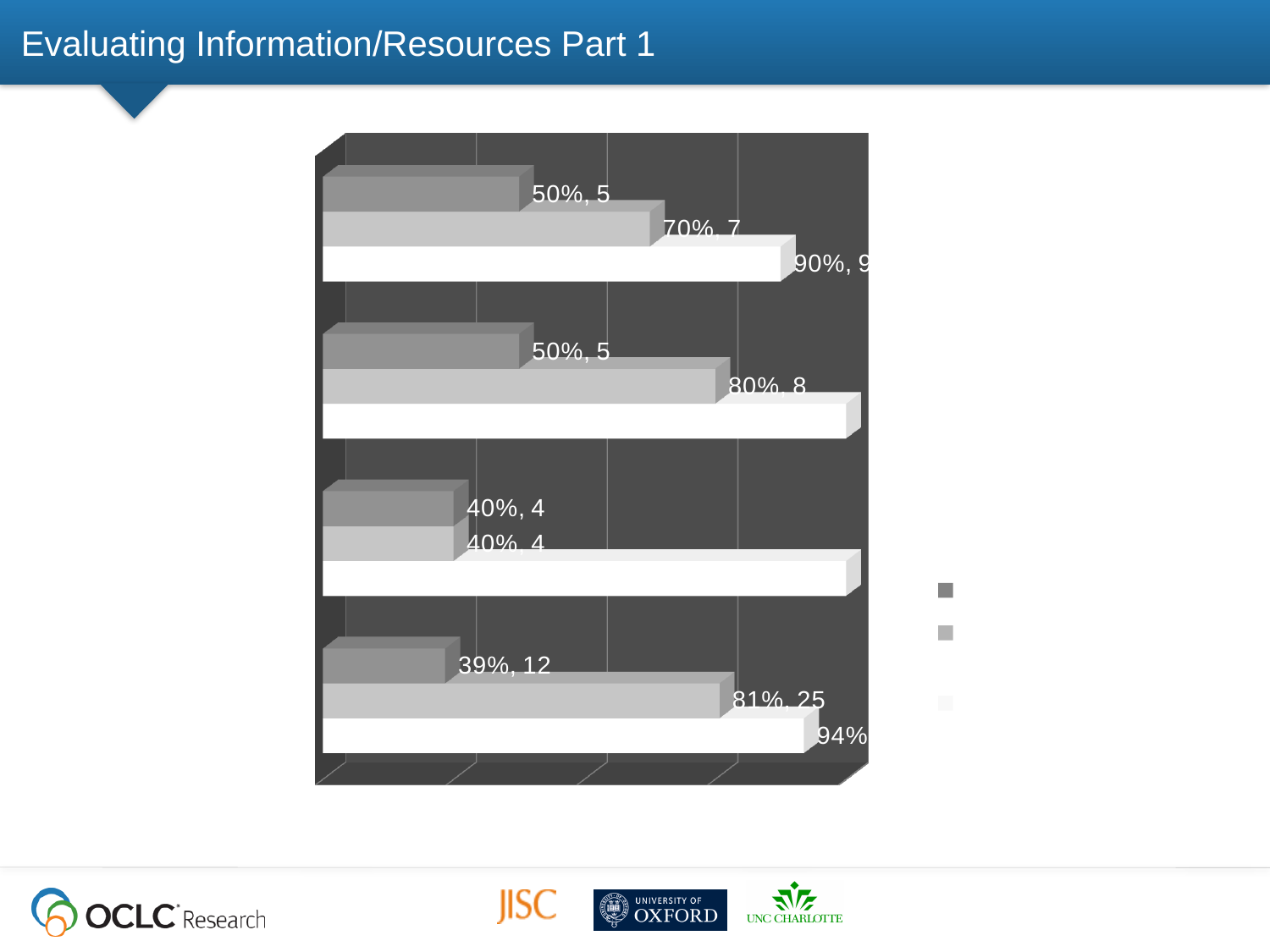
In the top group, how much higher is the white bar's percentage than the dark grey bar's percentage? 40% How many groups of bars does the chart contain? 4 What is the lowest percentage printed on the chart? 39% What is the data label on the light grey bar in the bottom group? 81%, 25 What is the data label on the white bar in the top group? 90%, 9 What is the data label on the dark grey bar in the bottom group? 39%, 12 What is the highest percentage printed on the chart? 94% How many series does the legend show? 3 What kind of chart is shown on the slide? bar chart In the top group, which bar is longer, the white bar or the dark grey bar? the white bar What is the data label on the light grey bar in the second group from the top? 80%, 8 What is the title of the slide? Evaluating Information/Resources Part 1